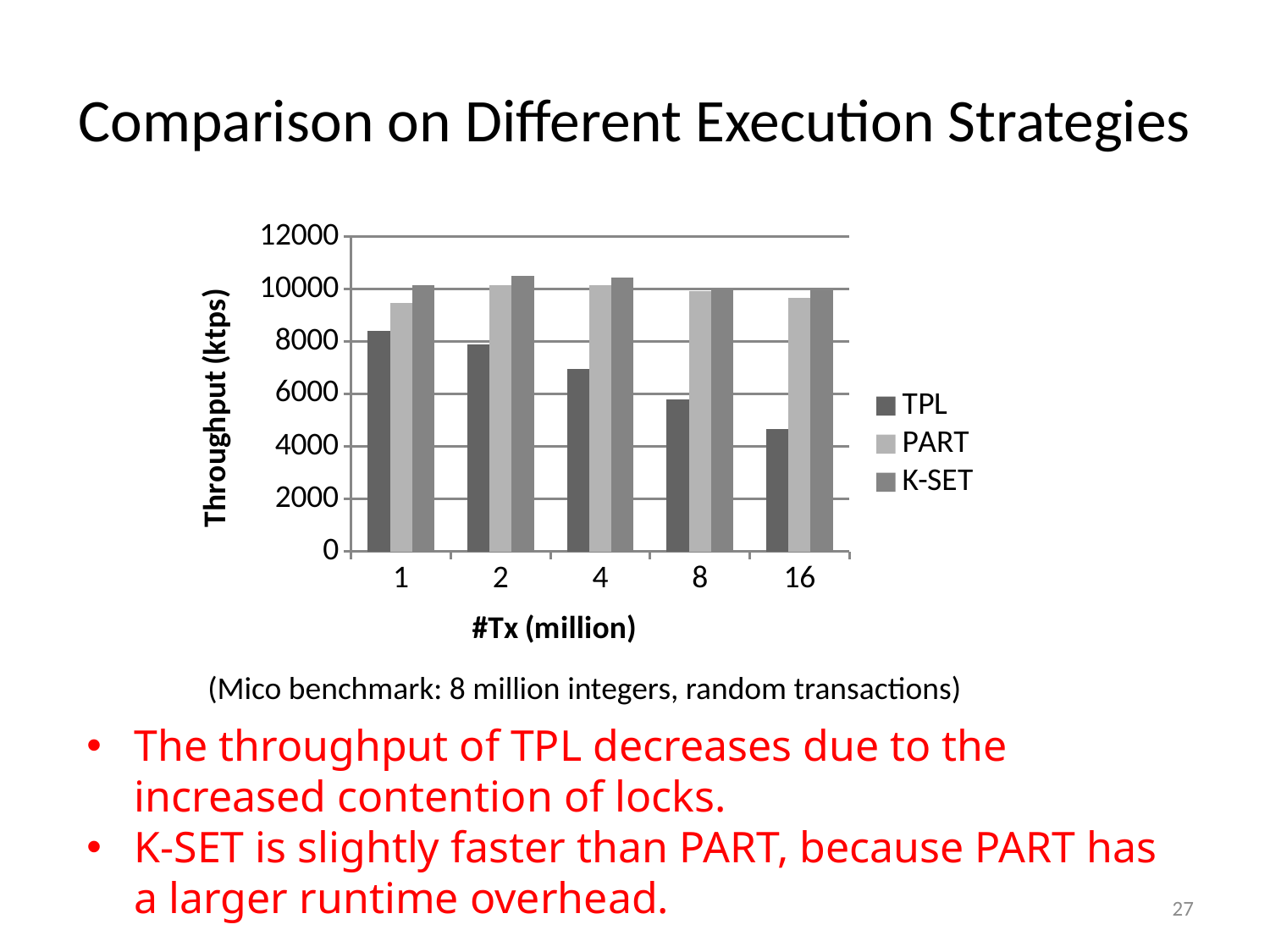
Is the K-SET throughput at 2 million transactions greater or less than 10000? greater Does the throughput of TPL rise or fall as #Tx (million) increases from 1 to 16? fall Is the TPL throughput at 16 million transactions greater or less than 6000? less How many #Tx (million) categories are shown on the x axis? 5 At 16 million transactions, which has the higher throughput, TPL or K-SET? K-SET At which #Tx (million) value is the TPL throughput lowest? 16 What is the label of the y axis? Throughput (ktps) Is the TPL throughput at 8 million transactions greater or less than 8000? less What kind of chart is shown on the slide? bar chart How many series does the legend list? 3 At 4 million transactions, which has the higher throughput, TPL or PART? PART